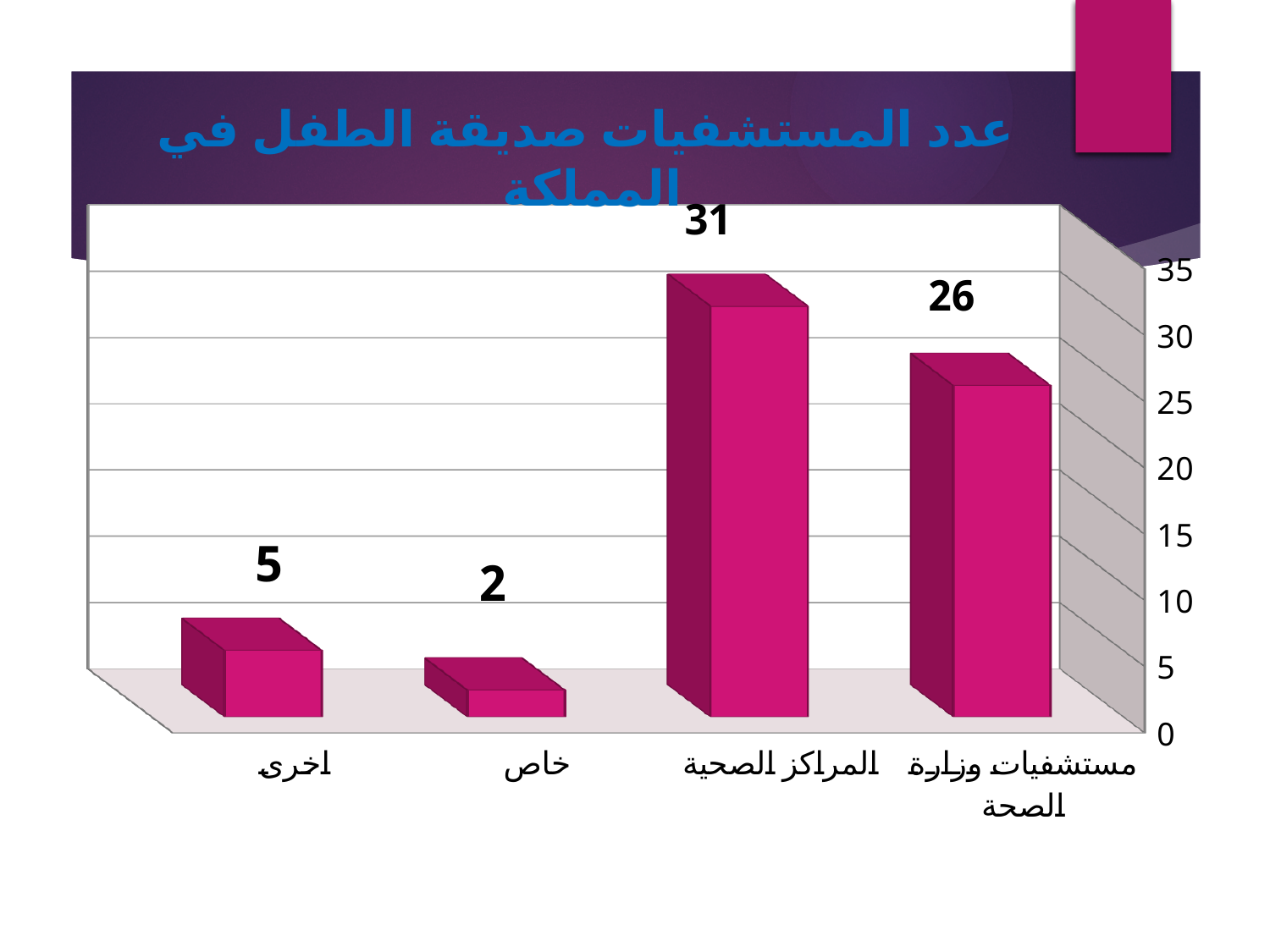
What kind of chart is shown on the slide? bar chart Which category has the lowest value? خاص What is the value for خاص? 2 What is the difference between the values for المراكز الصحية and مستشفيات وزارة الصحة? 5 What is the title of the chart? عدد المستشفيات صديقة الطفل في المملكة How many categories are shown in the chart? 4 Which category has the highest value? المراكز الصحية What is the value for مستشفيات وزارة الصحة? 26 Which is larger, the value for اخرى or the value for خاص? اخرى Is the value for مستشفيات وزارة الصحة greater or less than 20? greater What is the value for المراكز الصحية? 31 What is the value for اخرى? 5